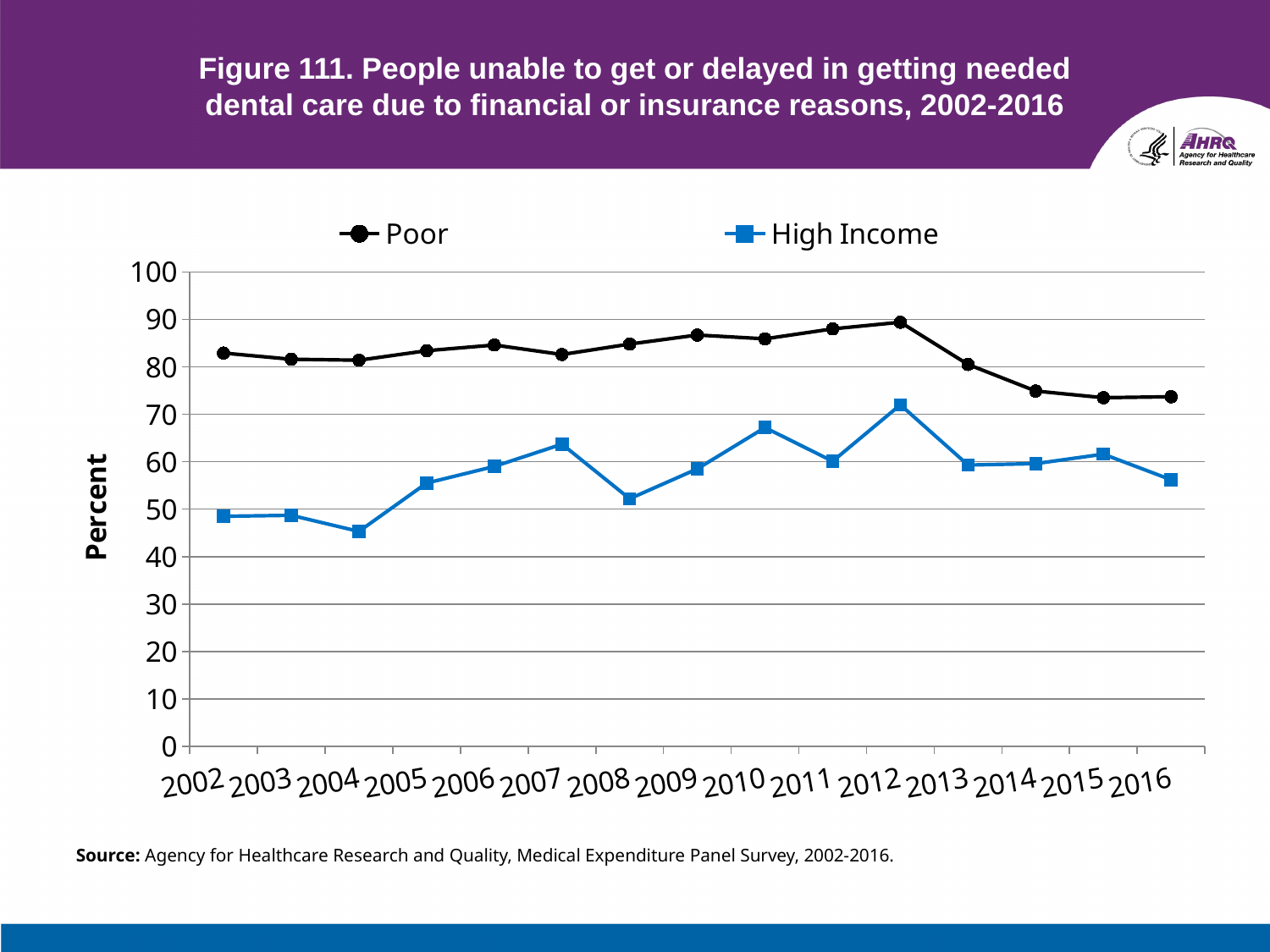
In 2010, which series has the larger value, Poor or High Income? Poor In which year does the High Income series reach its lowest value? 2004 Is the value for Poor in 2016 greater or less than 70? greater What is the label on the vertical axis? Percent In which year does the High Income series reach its highest value? 2012 How many years are plotted along the x axis? 15 Does the Poor series rise or fall from 2012 to 2016? fall What kind of chart is shown on the slide? line chart In which year does the Poor series reach its highest value? 2012 Is the value for Poor in 2012 greater or less than 80? greater How many series does the legend list? 2 Is the value for High Income in 2004 greater or less than 50? less